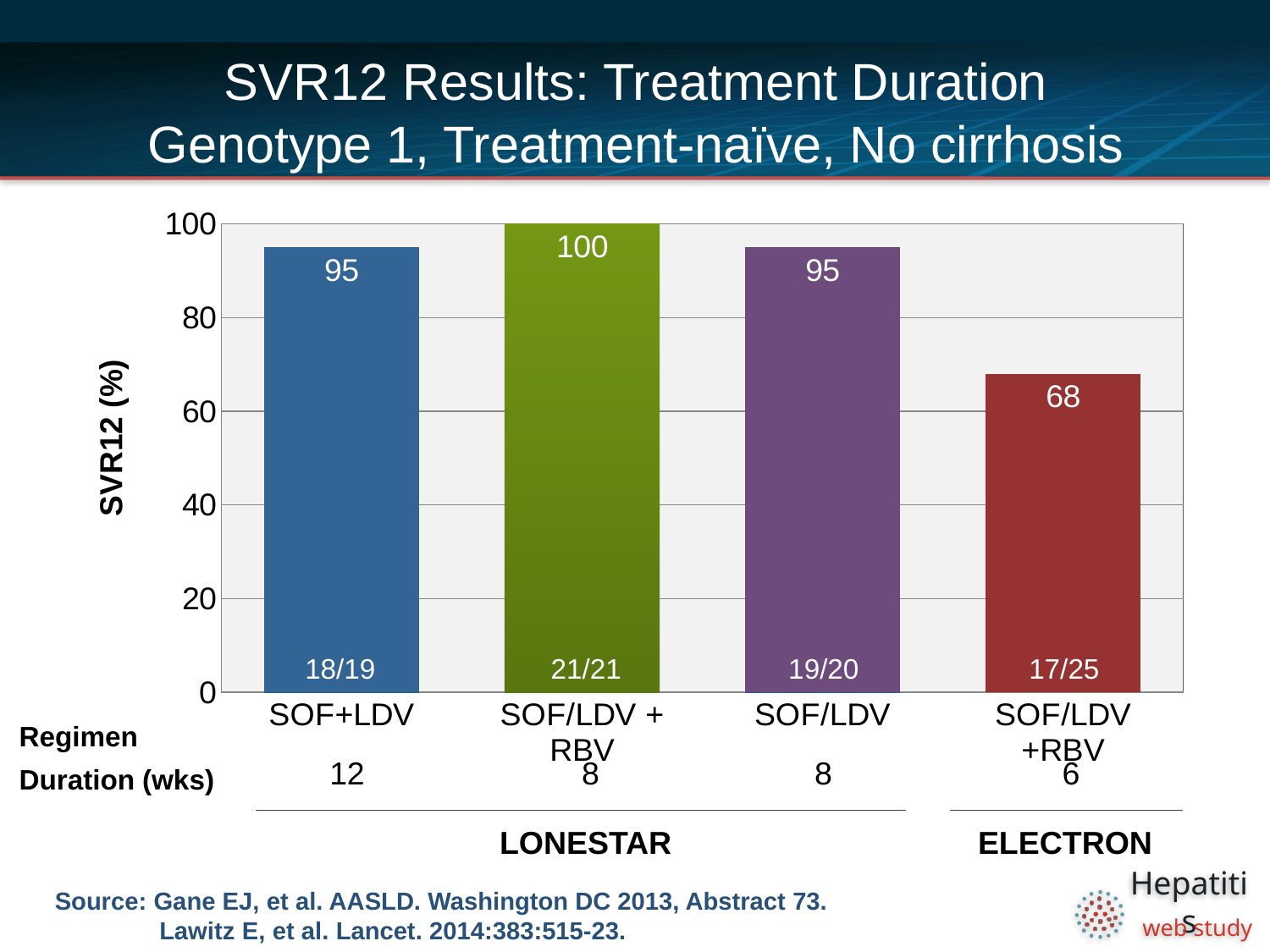
What type of chart is shown on the slide? bar chart What is the difference in SVR12 between the SOF/LDV + RBV 8-week regimen and the SOF/LDV +RBV 6-week regimen? 32 Which has a higher SVR12: the SOF/LDV 8-week regimen or the SOF/LDV +RBV 6-week regimen? SOF/LDV (8 wks) Which regimen has the highest SVR12 value? SOF/LDV + RBV (8 wks) What fraction of patients is shown at the base of the SOF/LDV 8-week bar? 19/20 How many bars are shown in the chart? 4 Is the SVR12 value for the SOF/LDV +RBV 6-week regimen greater or less than 80? less Which study does the SOF/LDV +RBV 6-week bar belong to? ELECTRON Which regimen has the lowest SVR12 value? SOF/LDV +RBV (6 wks) What is the SVR12 value for the SOF+LDV 12-week regimen? 95 What is the SVR12 value for the SOF/LDV + RBV 6-week regimen in ELECTRON? 68 What is the SVR12 value for the SOF/LDV + RBV 8-week regimen? 100